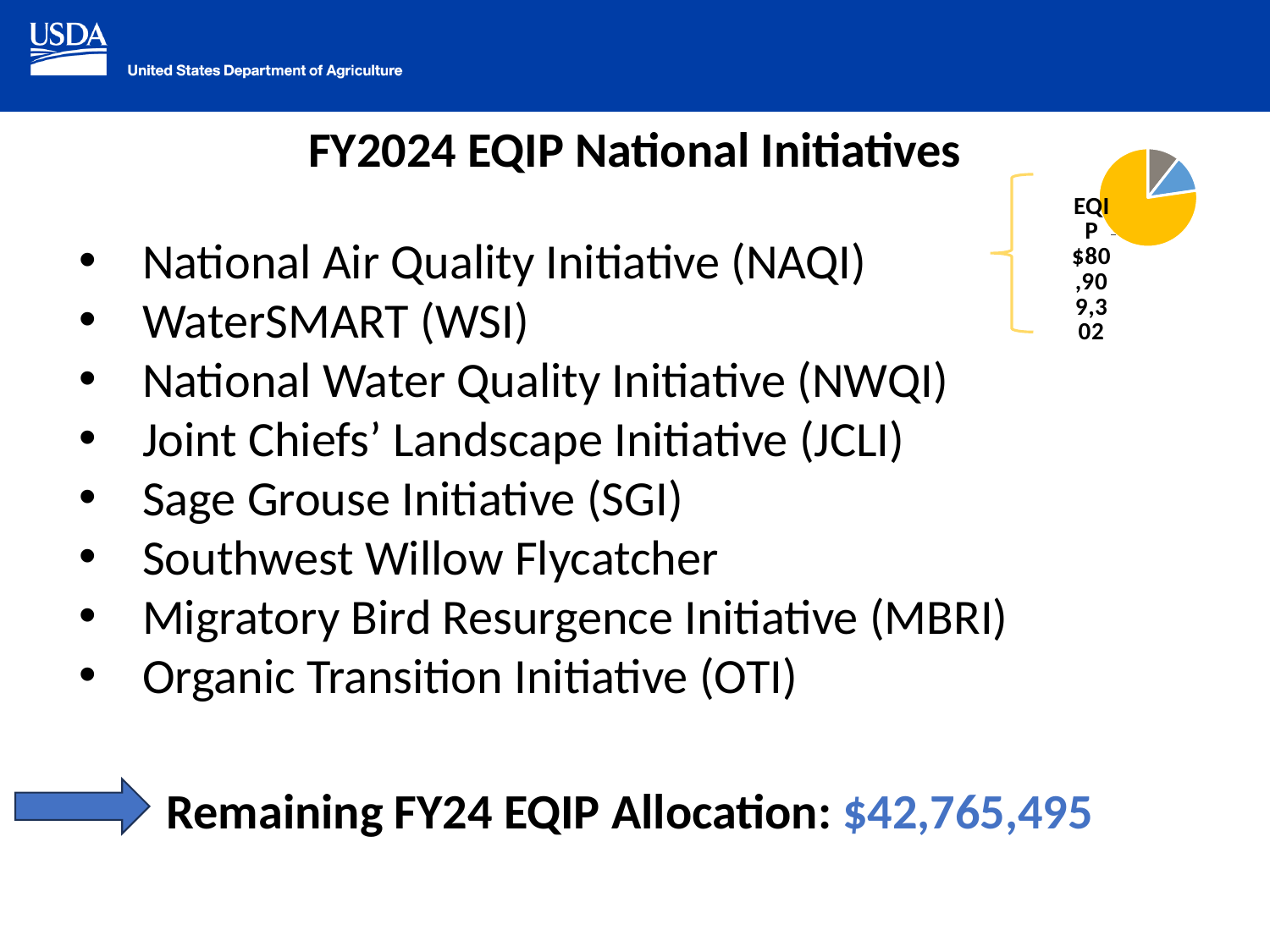
Is the yellow slice of the pie chart larger or smaller than the blue slice? larger How many slices does the pie chart have? 3 What kind of chart is shown on the slide? pie chart Which slice of the pie chart has a data label printed on the slide? EQIP Is the gray slice of the pie chart larger or smaller than the yellow slice? smaller What value is printed for EQIP on the pie chart? $80,909,302 Which colour is the largest slice of the pie chart? yellow Which slice of the pie chart is the largest? EQIP